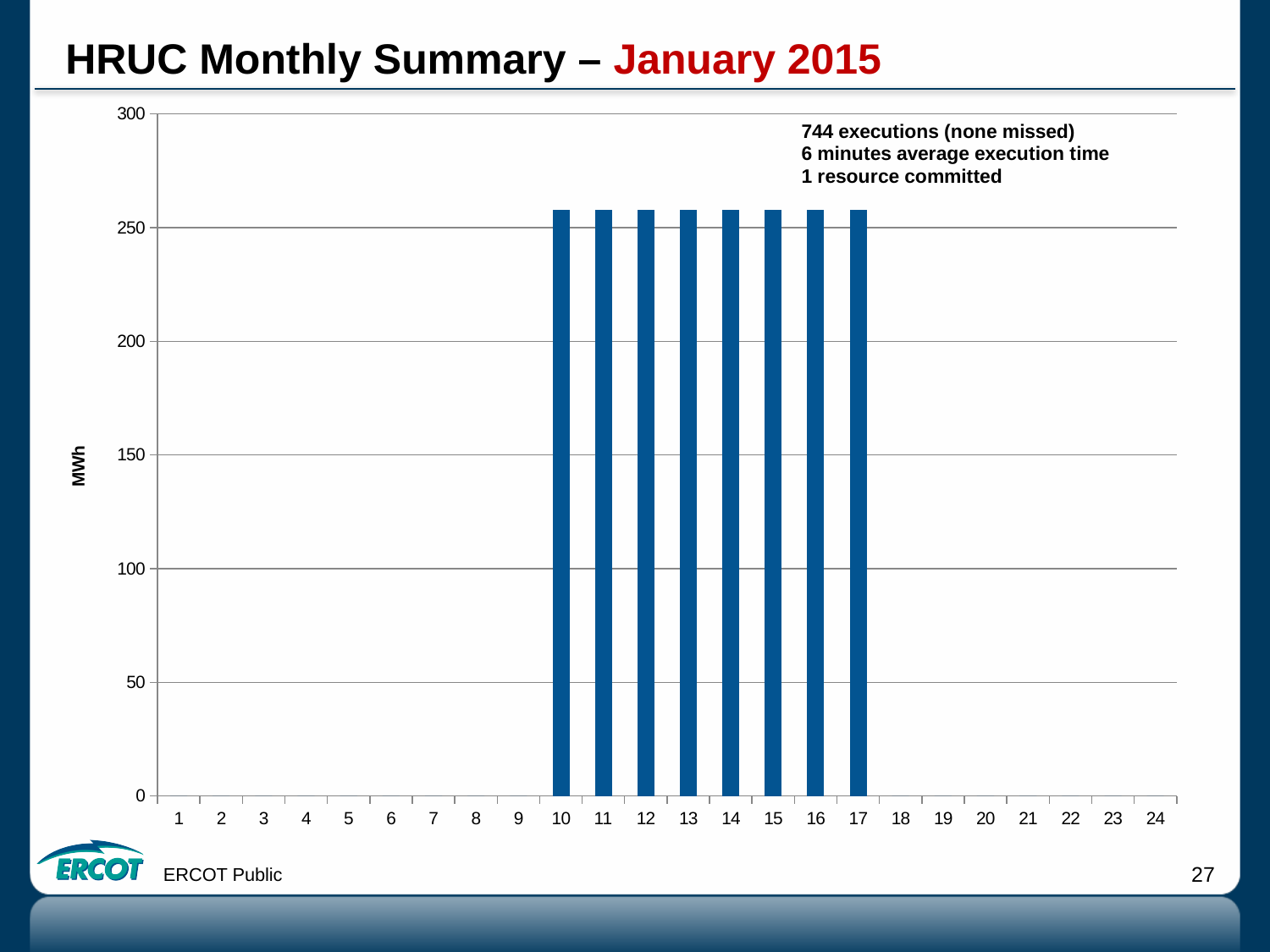
According to the text on the chart, what was the average execution time? 6 minutes What kind of chart is shown on the slide? bar chart According to the text on the chart, how many resources were committed? 1 How many hours on the chart have a non-zero bar? 8 How many categories are shown along the x axis of the chart? 24 What is the label on the y axis of the chart? MWh Is the value for hour 15 greater or less than 300? less Is the value for hour 12 greater or less than 200? greater Is the value for hour 10 greater or less than 100? greater